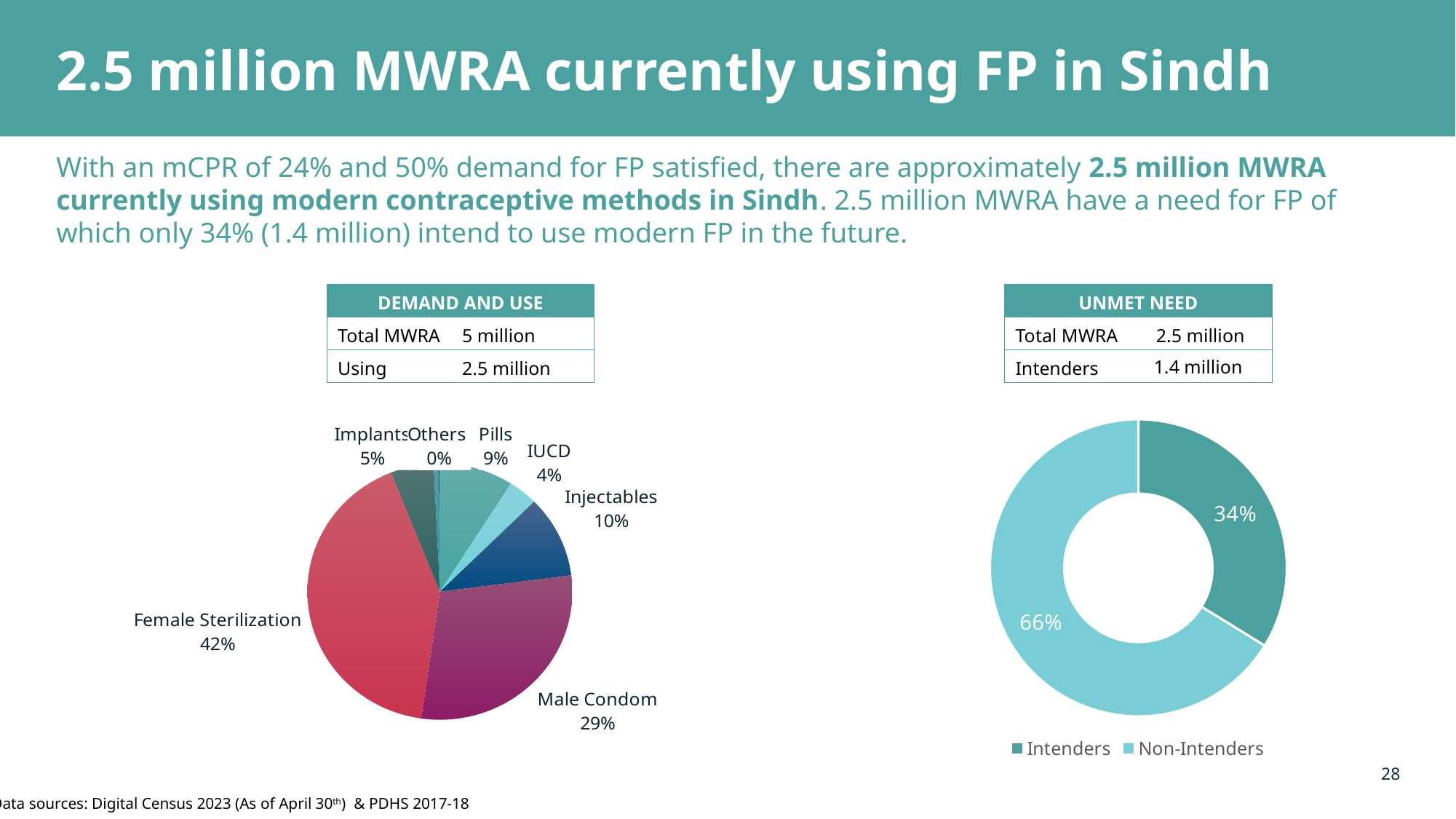
How many entries does the legend of the donut chart on the right list? 2 In the pie chart on the left, what share is Injectables? 10% In the donut chart on the right, what share is Non-Intenders? 66% In the pie chart on the left, what share is IUCD? 4% In the pie chart on the left, what is the difference in percentage points between Female Sterilization and Male Condom? 13 In the pie chart on the left, which method has the largest share? Female Sterilization In the pie chart on the left, which is larger, Pills or Implants? Pills What kind of chart is the chart on the right? Donut chart In the pie chart on the left, what share is Male Condom? 29% In the pie chart on the left, what share is Female Sterilization? 42%